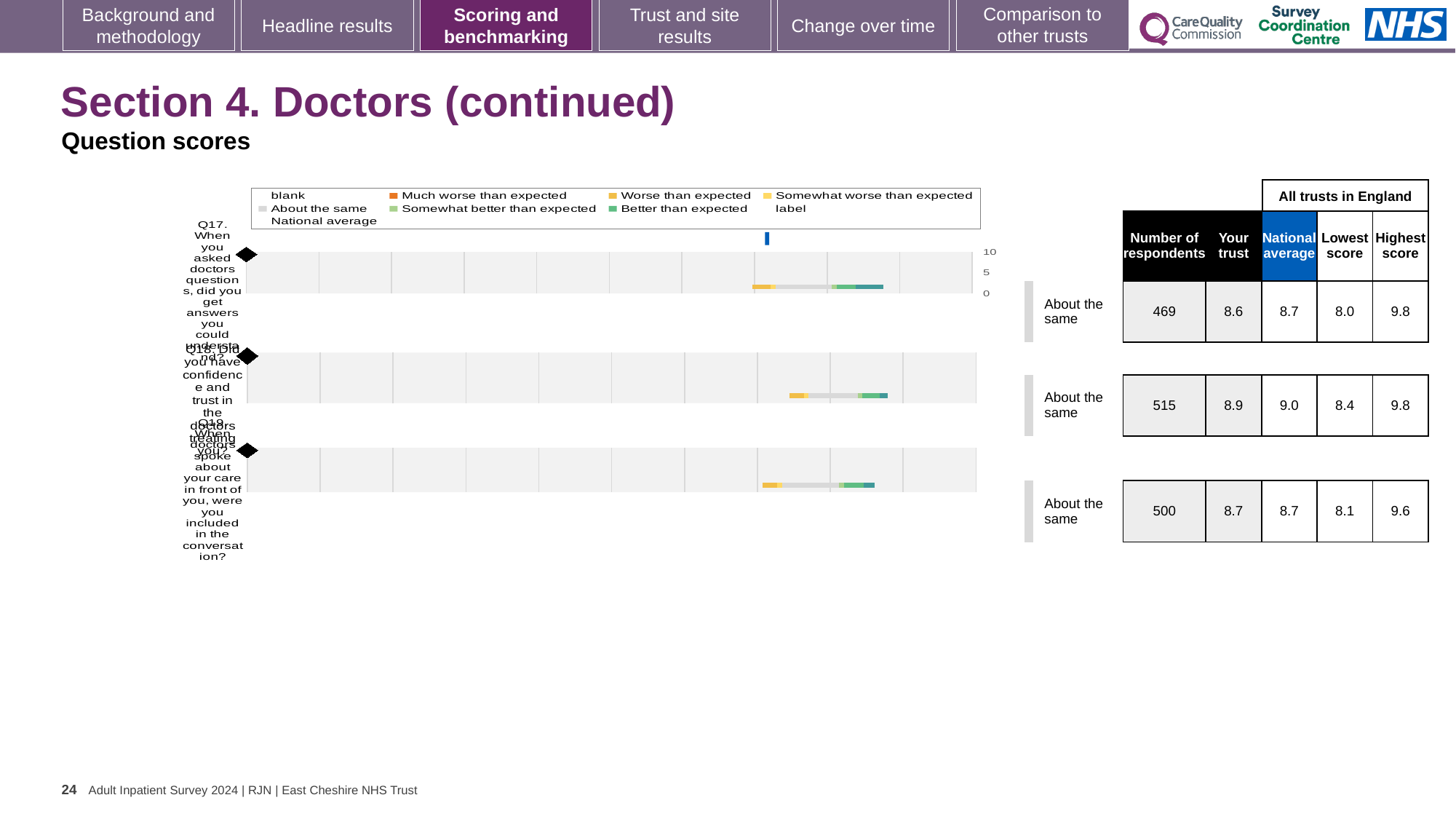
How many questions (Q17, Q18, Q19) are plotted in the chart area? 3 Which question has the largest number of respondents? Q18 What is the highest value shown on the chart's score axis? 10 In the chart legend, what colour represents 'Much worse than expected'? orange In the table beside the chart, what is the 'Your trust' score for Q17 (answers you could understand)? 8.6 In the table beside the chart, what is the national average for Q18 (confidence and trust in doctors)? 9.0 What benchmark category is shown for Q19 next to the chart? About the same What kind of chart is used to show the question scores on this slide? bar chart For Q18, which is larger: the 'Your trust' score or the national average? National average How many respondents answered Q19? 500 In the table beside the chart, what is the highest score for Q19 (included in the conversation)? 9.6 For Q17, what is the difference between the highest score (9.8) and the lowest score (8.0) across all trusts in England? 1.8